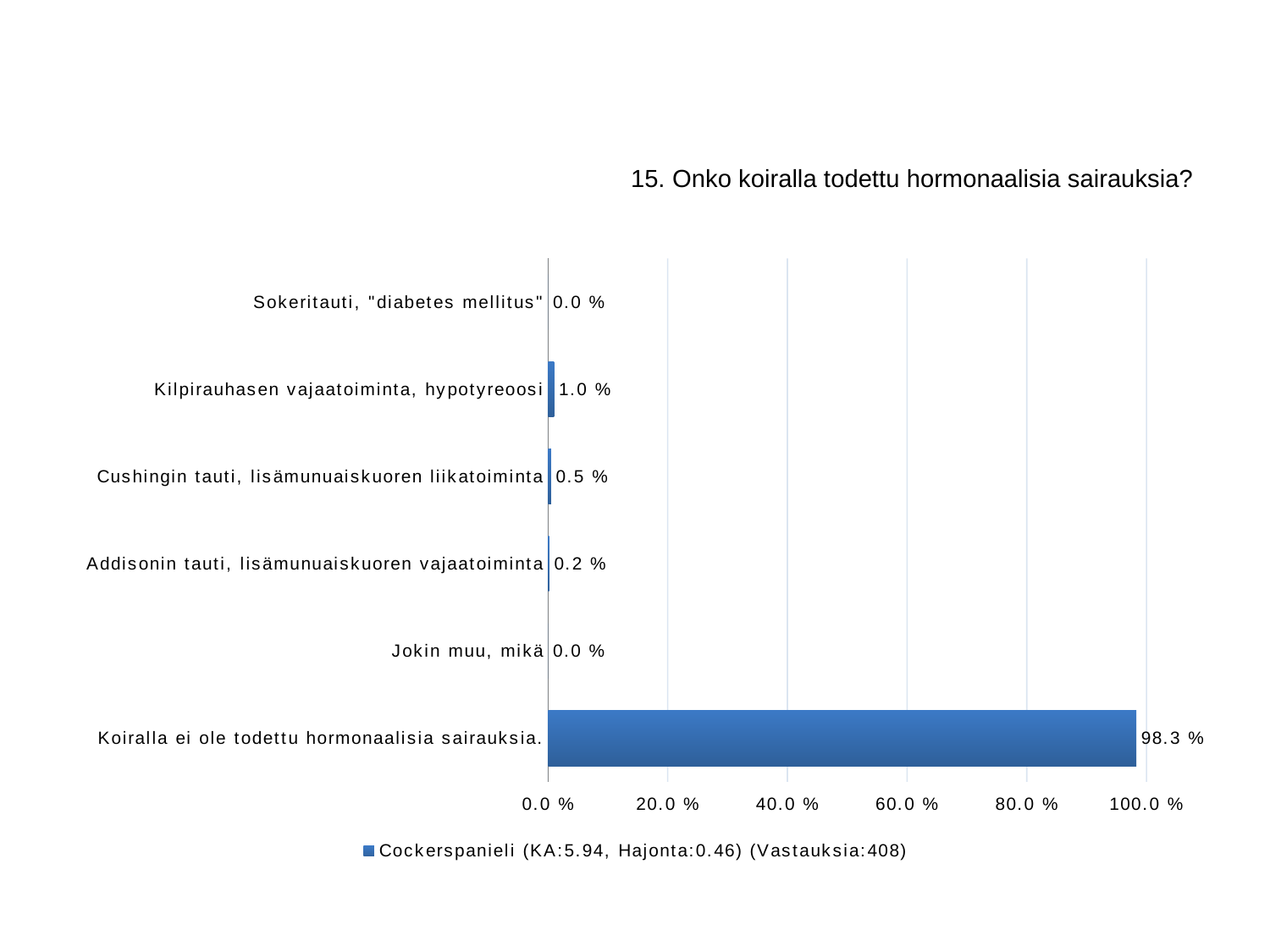
What is the value for "Koiralla ei ole todettu hormonaalisia sairauksia."? 98.3 % What is the value for "Cushingin tauti, lisämunuaiskuoren liikatoiminta"? 0.5 % Is the value for "Koiralla ei ole todettu hormonaalisia sairauksia." greater or less than 80.0 %? greater How many categories are shown in the chart? 6 What is the difference between the values for "Kilpirauhasen vajaatoiminta, hypotyreoosi" and "Cushingin tauti, lisämunuaiskuoren liikatoiminta"? 0.5 % How many series does the legend list? 1 What is the value for "Addisonin tauti, lisämunuaiskuoren vajaatoiminta"? 0.2 % Which is larger, the value for "Kilpirauhasen vajaatoiminta, hypotyreoosi" or the value for "Addisonin tauti, lisämunuaiskuoren vajaatoiminta"? Kilpirauhasen vajaatoiminta, hypotyreoosi What is the value for "Kilpirauhasen vajaatoiminta, hypotyreoosi"? 1.0 % What is the title of the chart? 15. Onko koiralla todettu hormonaalisia sairauksia? What kind of chart is shown on the slide? bar chart Which category has the highest value? Koiralla ei ole todettu hormonaalisia sairauksia.